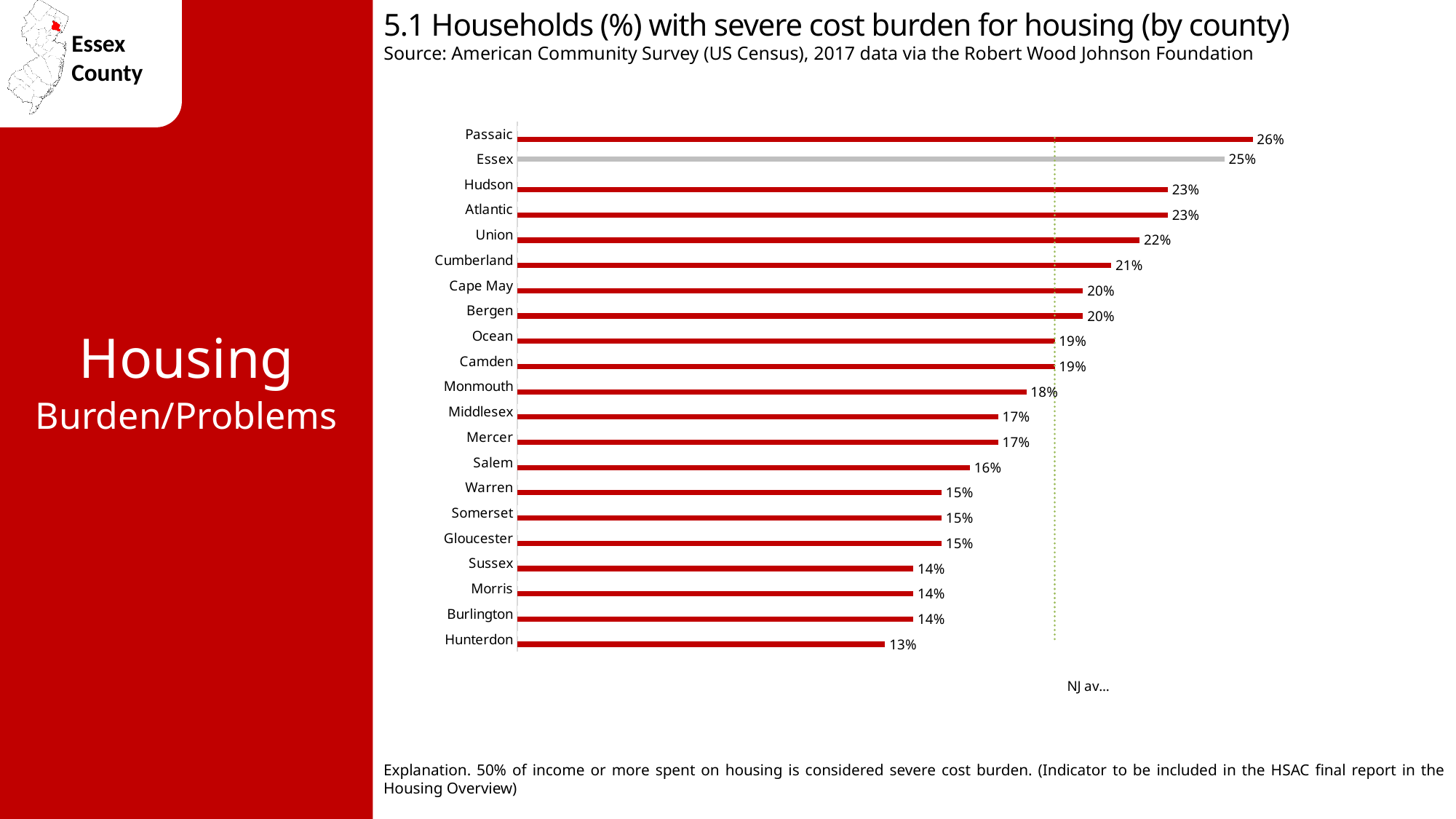
How many counties are shown in the chart? 21 What is the difference between the values for Essex and Union? 3% What kind of chart is this? Bar chart What is the value for Cumberland? 21% Which county has the lowest value? Hunterdon Which county's bar is coloured grey instead of red? Essex What is the value for Essex? 25% What is the value for Hunterdon? 13% Which county has the highest value? Passaic Which is larger, the value for Hudson or the value for Salem? Hudson What is the difference between the values for Passaic and Hunterdon? 13% What is the title of the chart? 5.1 Households (%) with severe cost burden for housing (by county)